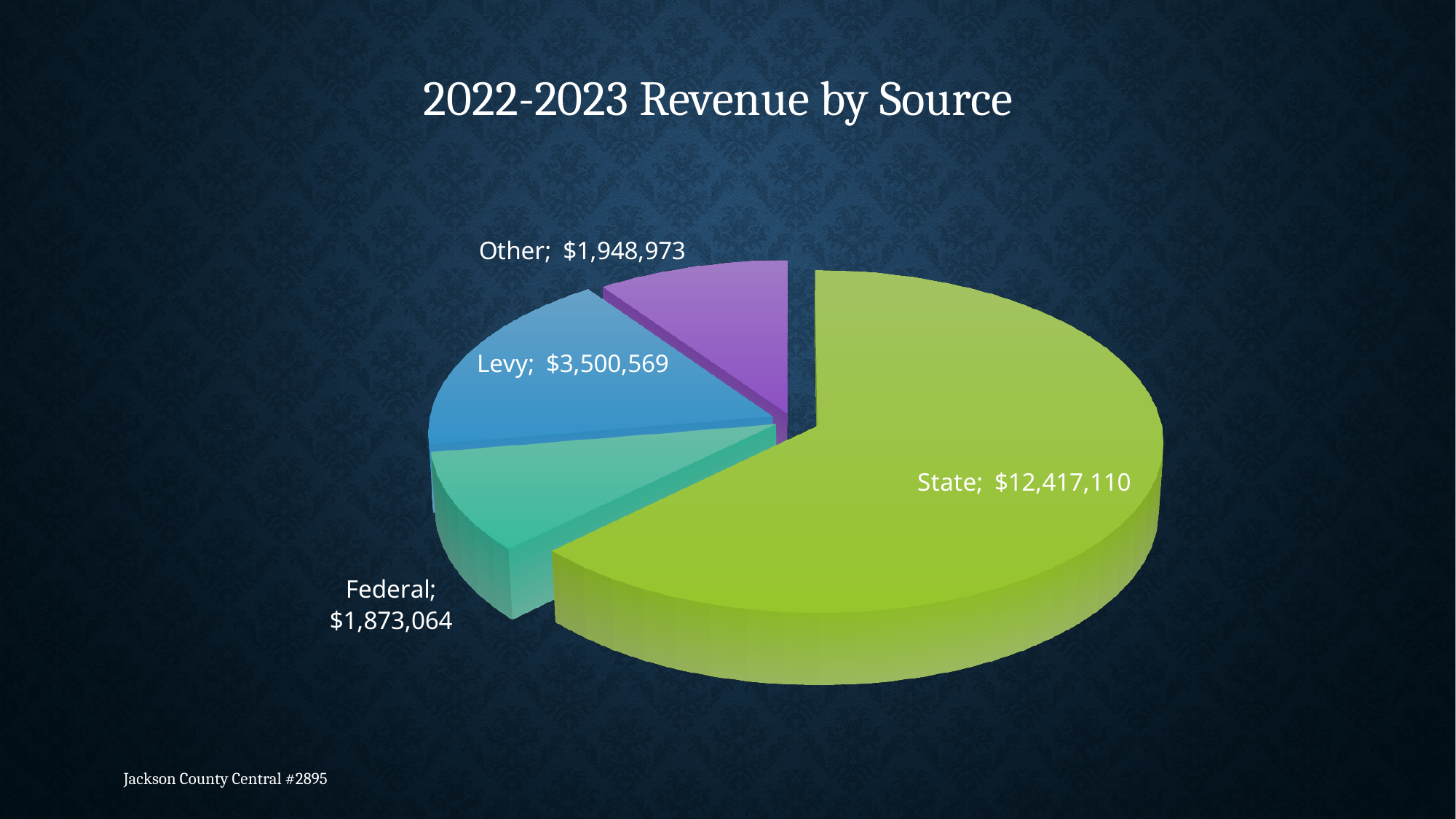
What is the title of the chart? 2022-2023 Revenue by Source What is the revenue value for Federal? $1,873,064 How many revenue sources (slices) does the pie chart show? 4 Which is larger, the revenue from Other or from Federal? Other Which revenue source has the smallest value? Federal What is the total revenue across all four sources shown? $19,739,716 Which revenue source has the largest value? State What is the revenue value for State? $12,417,110 What type of chart is shown on the slide? Pie chart What is the revenue value for Levy? $3,500,569 What is the revenue value for Other? $1,948,973 What is the difference between the State revenue and the Levy revenue? $8,916,541